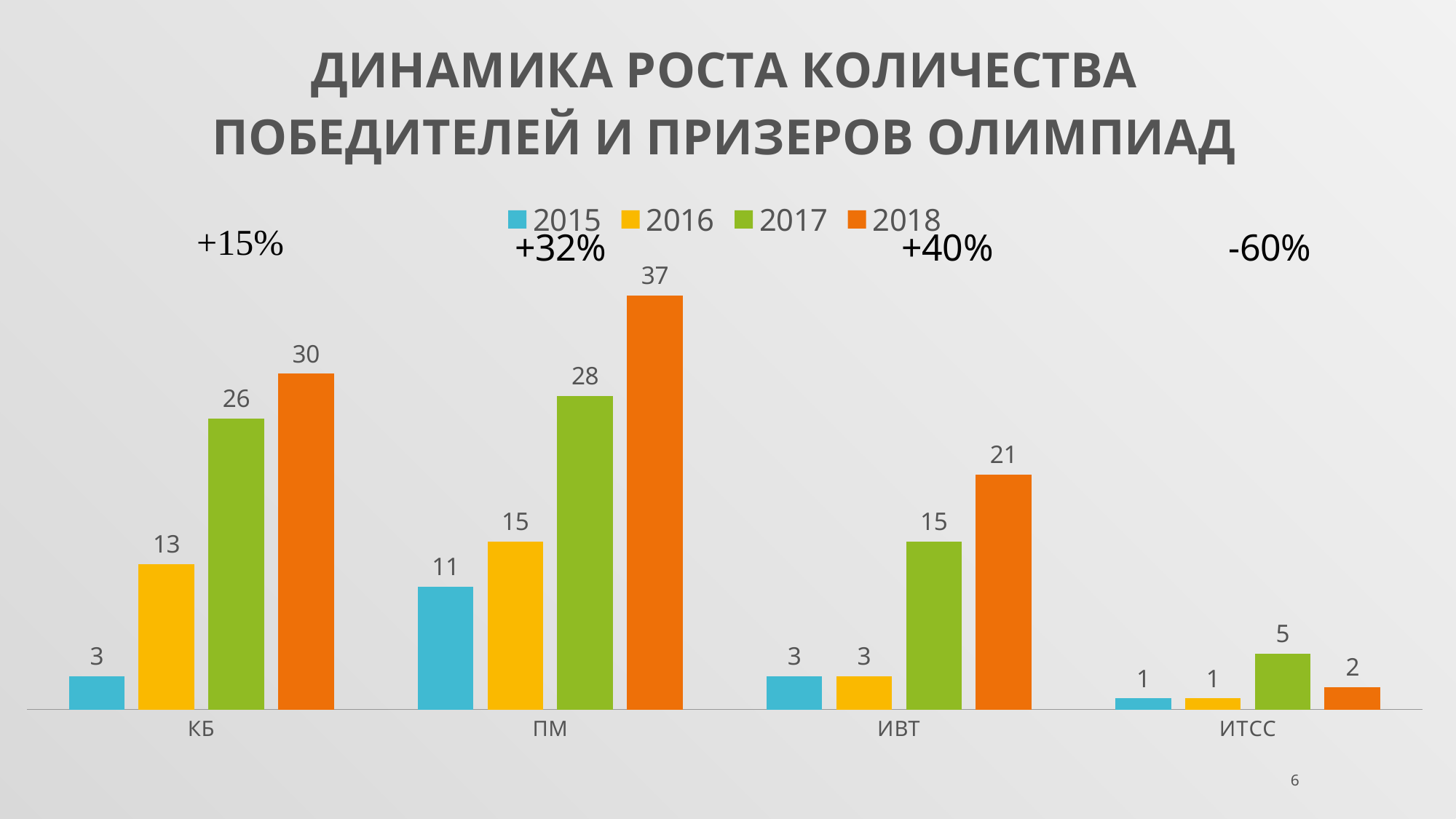
What kind of chart is shown on the slide? bar chart What is the value for КБ in 2016? 13 Which category has the lowest value in 2017? ИТСС How many categories are shown on the x axis? 4 What percentage change is annotated above the ИТСС group? -60% Which category has the highest value in 2018? ПМ What is the difference between the 2018 and 2017 values for ИВТ? 6 What is the value for ПМ in 2018? 37 What is the value for ИТСС in 2017? 5 How many series does the legend list? 4 Which is larger: the 2017 value for КБ or the 2017 value for ПМ? ПМ Do the values for ПМ rise or fall from 2015 to 2018? rise